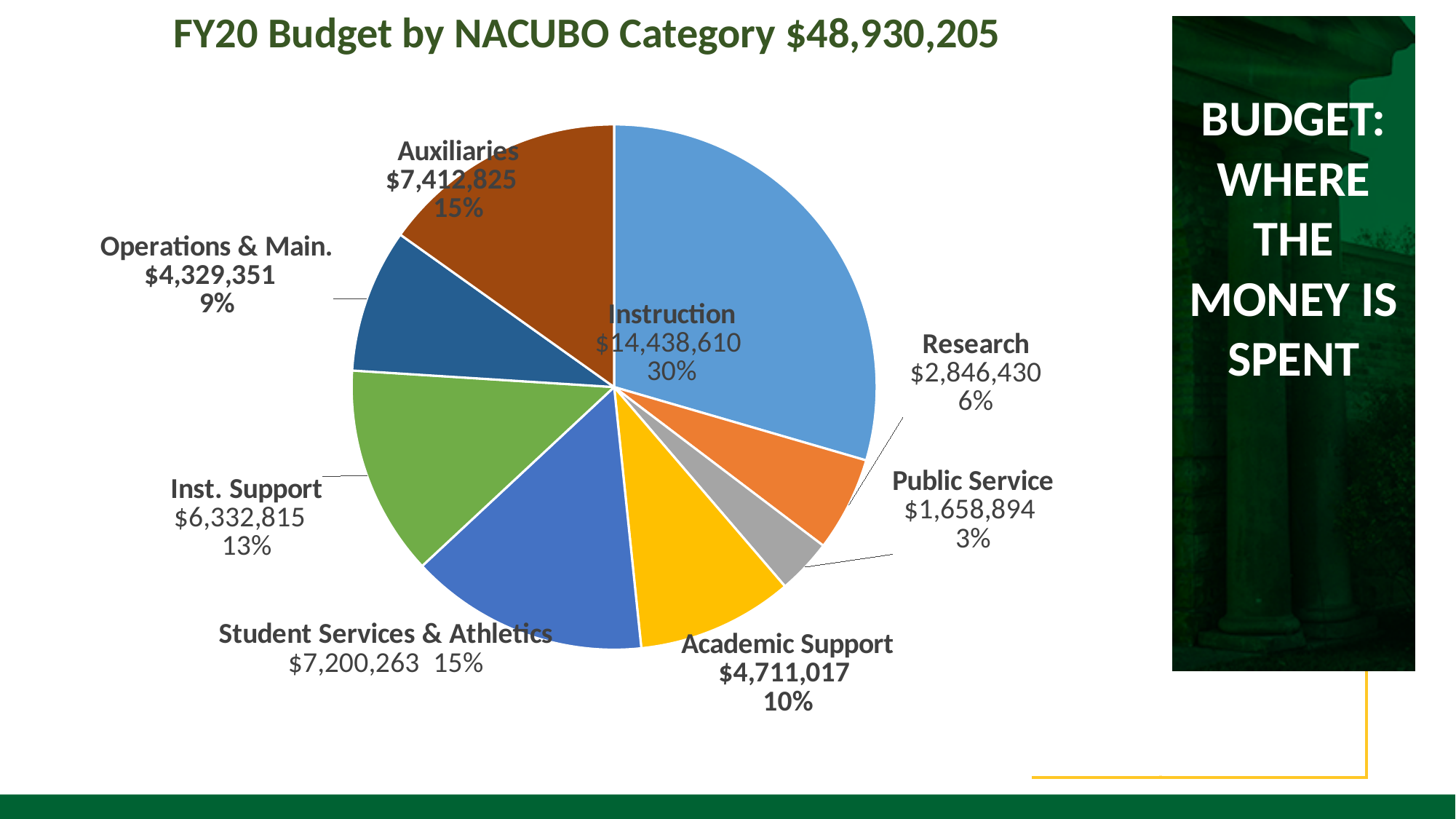
Which category has the largest share of the FY20 budget? Instruction What is the title of the chart? FY20 Budget by NACUBO Category $48,930,205 What type of chart is shown on the slide? Pie chart What is the budget amount for Instruction? $14,438,610 What is the budget amount for Public Service? $1,658,894 How many categories are shown in the pie chart? 8 What share of the pie does Academic Support represent? 10% What is the difference between the Instruction and Research budget amounts? $11,592,180 Which category has the smallest share of the FY20 budget? Public Service What is the budget amount for Operations & Main.? $4,329,351 Which has a larger budget amount, Auxiliaries or Student Services & Athletics? Auxiliaries What percentage of the budget goes to Inst. Support? 13%